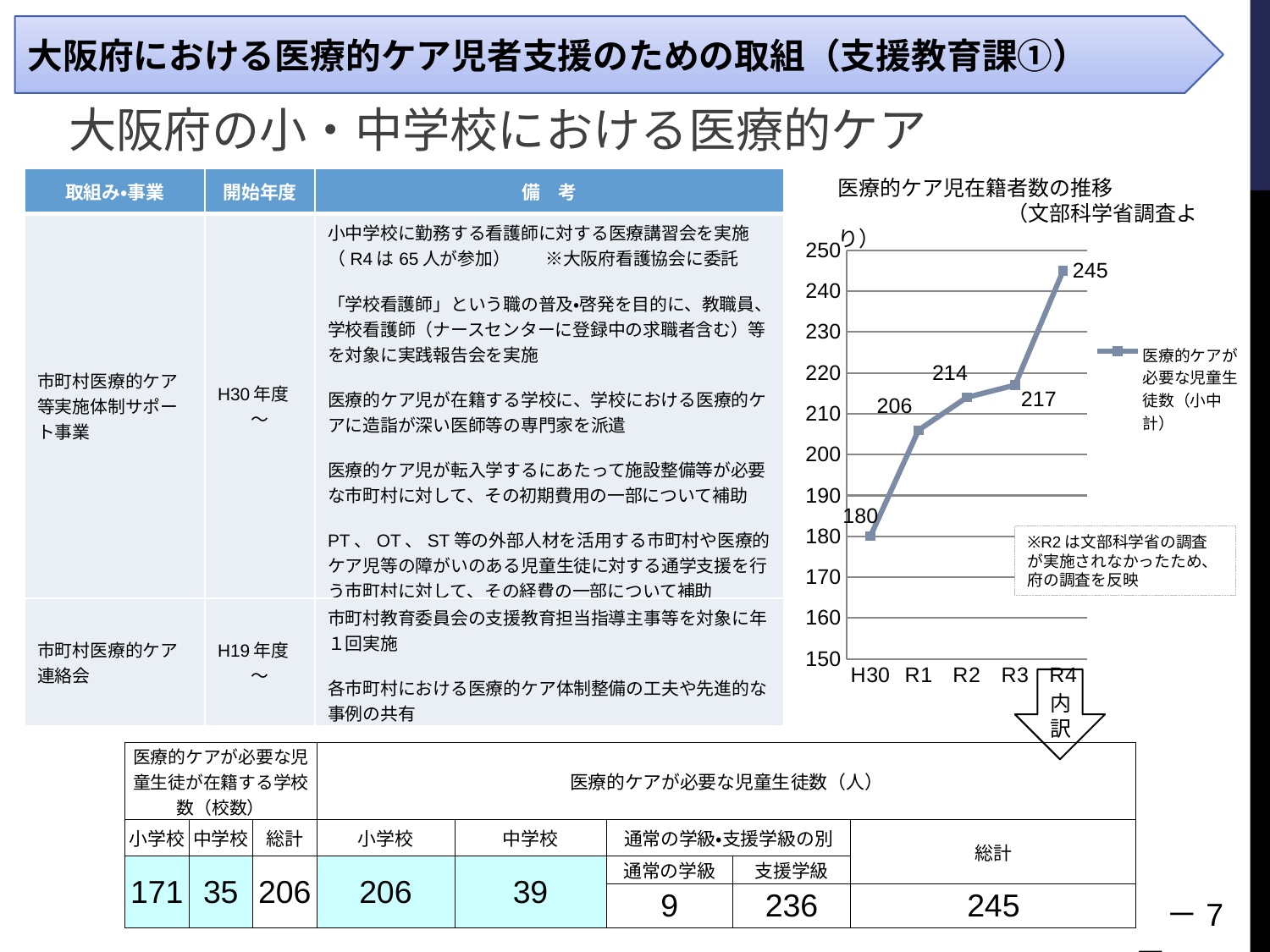
Which year has the highest value in the line chart? R4 What is the value for R2 in the line chart? 214 What kind of chart is shown on the slide? line chart What is the difference between the R4 value and the H30 value in the line chart? 65 How many data points are plotted in the line chart? 5 What is the value for R1 in the line chart? 206 What is the value for H30 in the line chart? 180 How many series does the legend of the line chart list? 1 What is the value for R4 in the line chart? 245 Which is larger in the line chart, the value for R1 or the value for R3? R3 Which year has the lowest value in the line chart? H30 Do the values in the line chart rise or fall from H30 to R4? rise